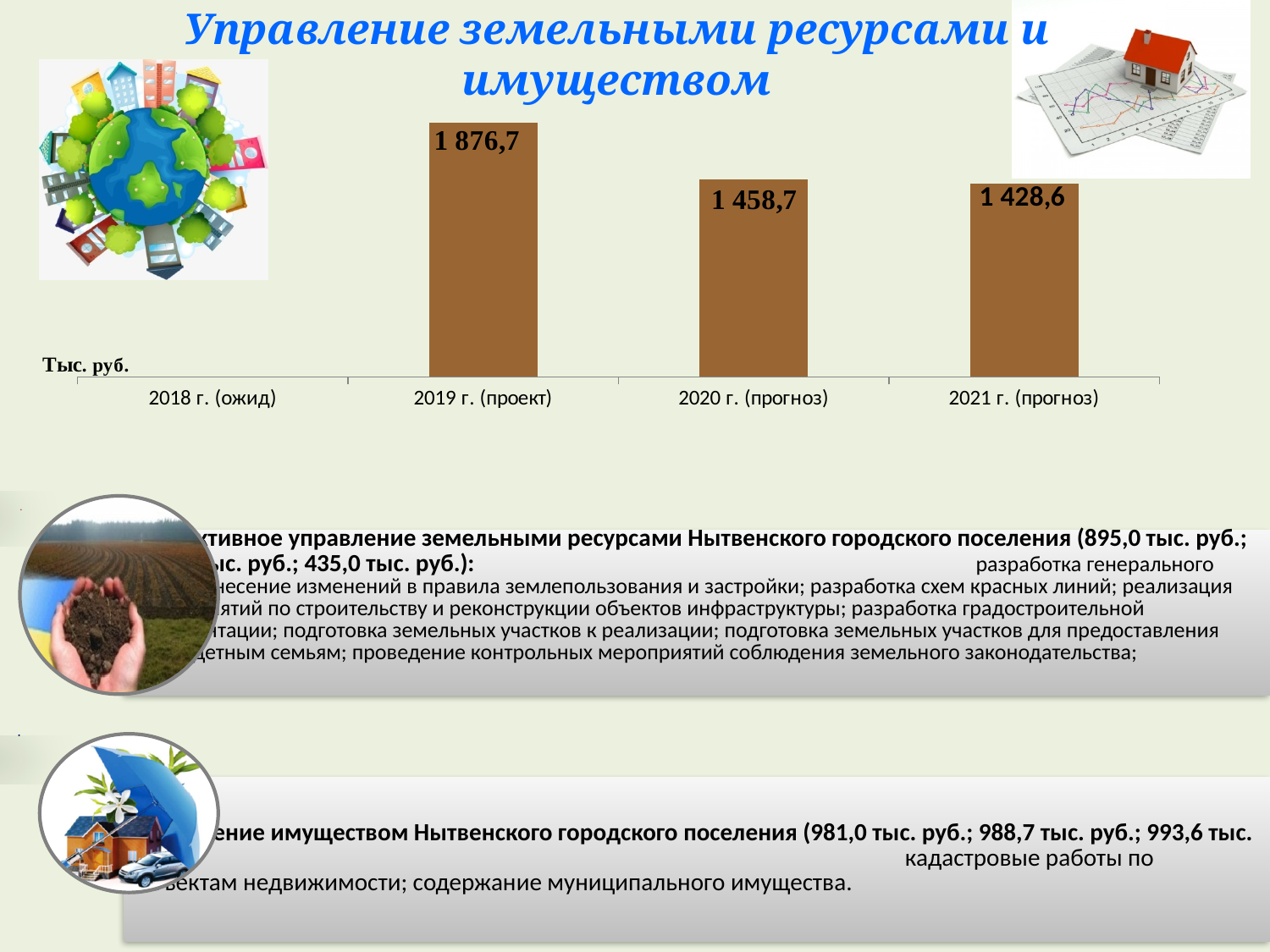
Do the values rise or fall from 2019 г. (проект) to 2021 г. (прогноз)? fall What is the difference between the values for 2019 г. (проект) and 2021 г. (прогноз)? 448,1 What is the value shown for 2020 г. (прогноз)? 1 458,7 Which category has the highest bar? 2019 г. (проект) How many categories are labelled on the x axis? 4 Which is larger, the value for 2020 г. (прогноз) or for 2021 г. (прогноз)? 2020 г. (прогноз) What kind of chart is shown on the slide? bar chart What is the difference between the values for 2019 г. (проект) and 2020 г. (прогноз)? 418,0 What is the difference between the values for 2020 г. (прогноз) and 2021 г. (прогноз)? 30,1 What is the value shown for 2021 г. (прогноз)? 1 428,6 What is the value shown for 2019 г. (проект)? 1 876,7 What unit label is shown next to the chart's axis? Тыс. руб.